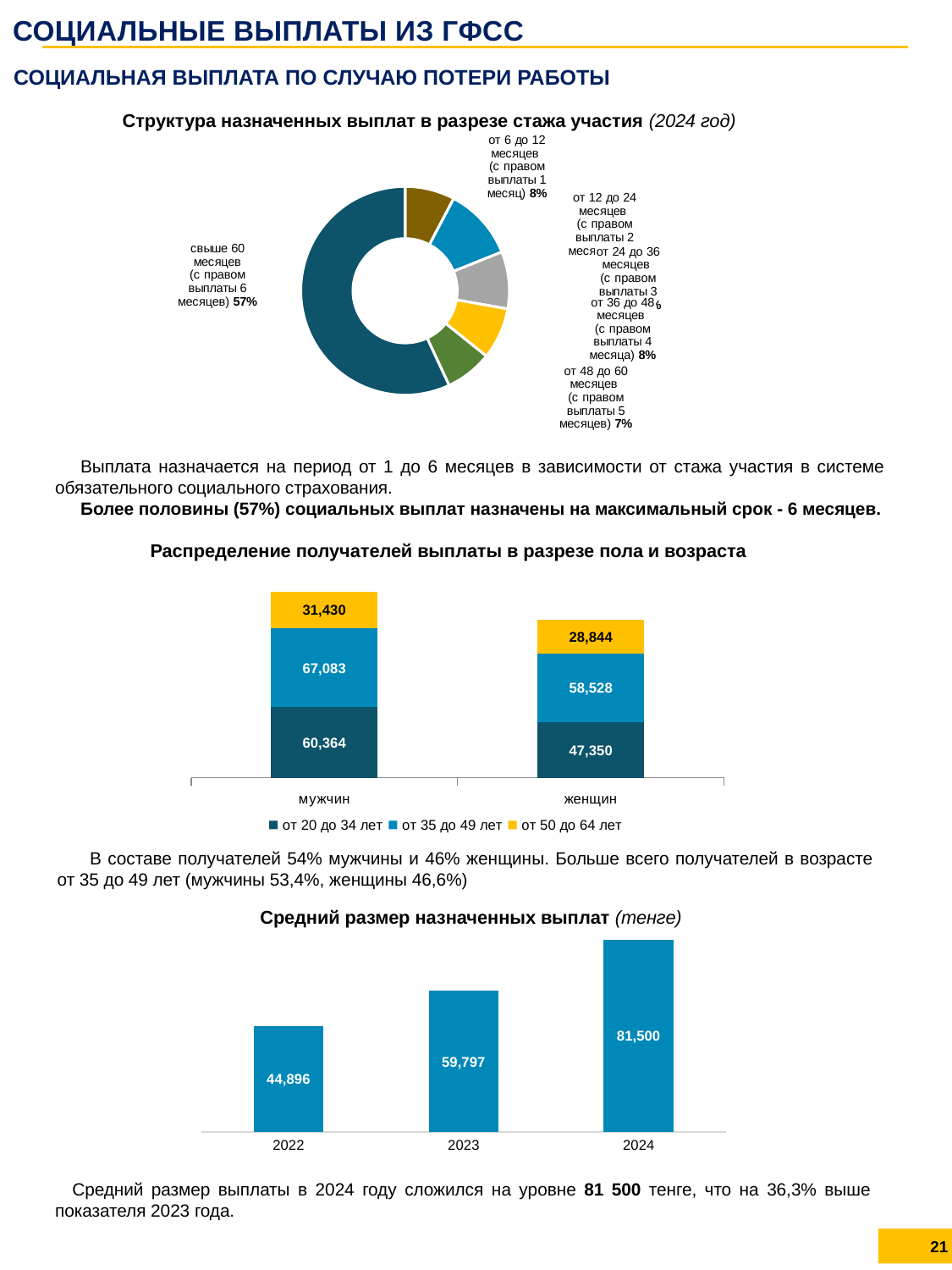
In the donut chart 'Структура назначенных выплат в разрезе стажа участия', what share is shown for 'от 48 до 60 месяцев (с правом выплаты 5 месяцев)'? 7% In the donut chart 'Структура назначенных выплат в разрезе стажа участия', what share is shown for 'свыше 60 месяцев (с правом выплаты 6 месяцев)'? 57% In the donut chart 'Структура назначенных выплат в разрезе стажа участия', which category has the largest share? свыше 60 месяцев (с правом выплаты 6 месяцев) In the chart 'Распределение получателей выплаты в разрезе пола и возраста', how many series does the legend list? 3 In the chart 'Распределение получателей выплаты в разрезе пола и возраста', what is the total of the stacked bar for 'мужчин'? 158,877 In the chart 'Распределение получателей выплаты в разрезе пола и возраста', what is the value for women aged 50 to 64 (от 50 до 64 лет)? 28,844 In the chart 'Средний размер назначенных выплат (тенге)', what is the difference between the 2024 and 2023 values? 21,703 In the chart 'Распределение получателей выплаты в разрезе пола и возраста', what is the difference between men and women aged 20 to 34 (от 20 до 34 лет)? 13,014 What kind of chart is 'Средний размер назначенных выплат (тенге)'? bar chart In the chart 'Средний размер назначенных выплат (тенге)', do the values rise or fall from 2022 to 2024? rise In the chart 'Распределение получателей выплаты в разрезе пола и возраста', what is the value for men aged 35 to 49 (от 35 до 49 лет)? 67,083 In the chart 'Средний размер назначенных выплат (тенге)', what is the value for 2023? 59,797